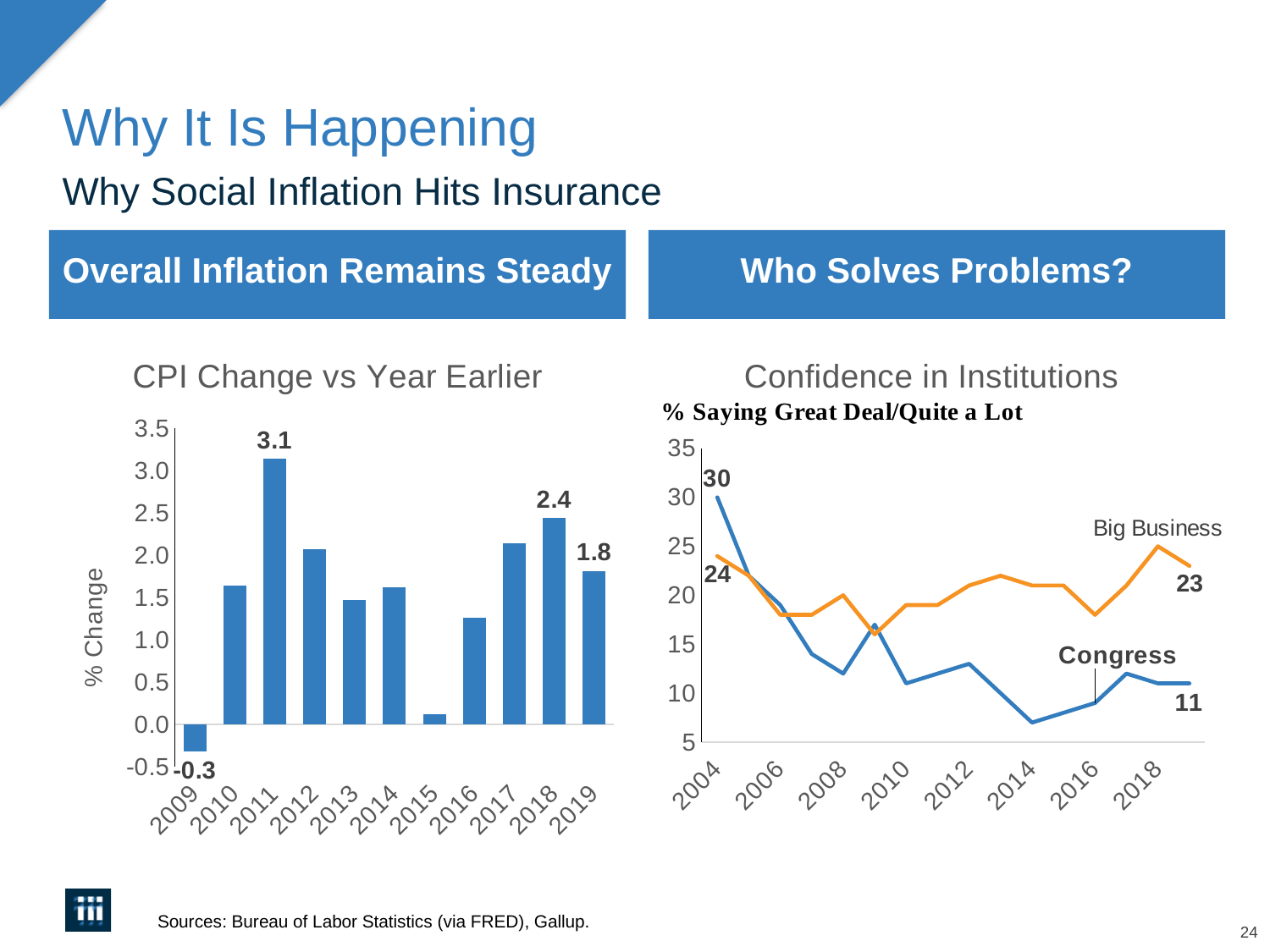
In the CPI Change vs Year Earlier chart, which year has the lowest value? 2009 In the CPI Change vs Year Earlier chart, which year has the highest value? 2011 In the Confidence in Institutions chart, by how much did the Congress value fall from its first labelled value (30) to its last labelled value (11)? 19 In the CPI Change vs Year Earlier chart, is the value for 2015 greater or less than 0.5? less In the Confidence in Institutions chart, what is the value for Congress in 2004? 30 How many years are shown in the CPI Change vs Year Earlier chart? 11 In the Confidence in Institutions chart, what is the latest value shown for Big Business? 23 What kind of chart is the CPI Change vs Year Earlier chart? Bar chart In the Confidence in Institutions chart, which was higher in 2004, Congress or Big Business? Congress In the CPI Change vs Year Earlier chart, what is the value for 2011? 3.1 In the CPI Change vs Year Earlier chart, what is the value for 2009? -0.3 In the CPI Change vs Year Earlier chart, what is the difference between the 2018 and 2019 values? 0.6